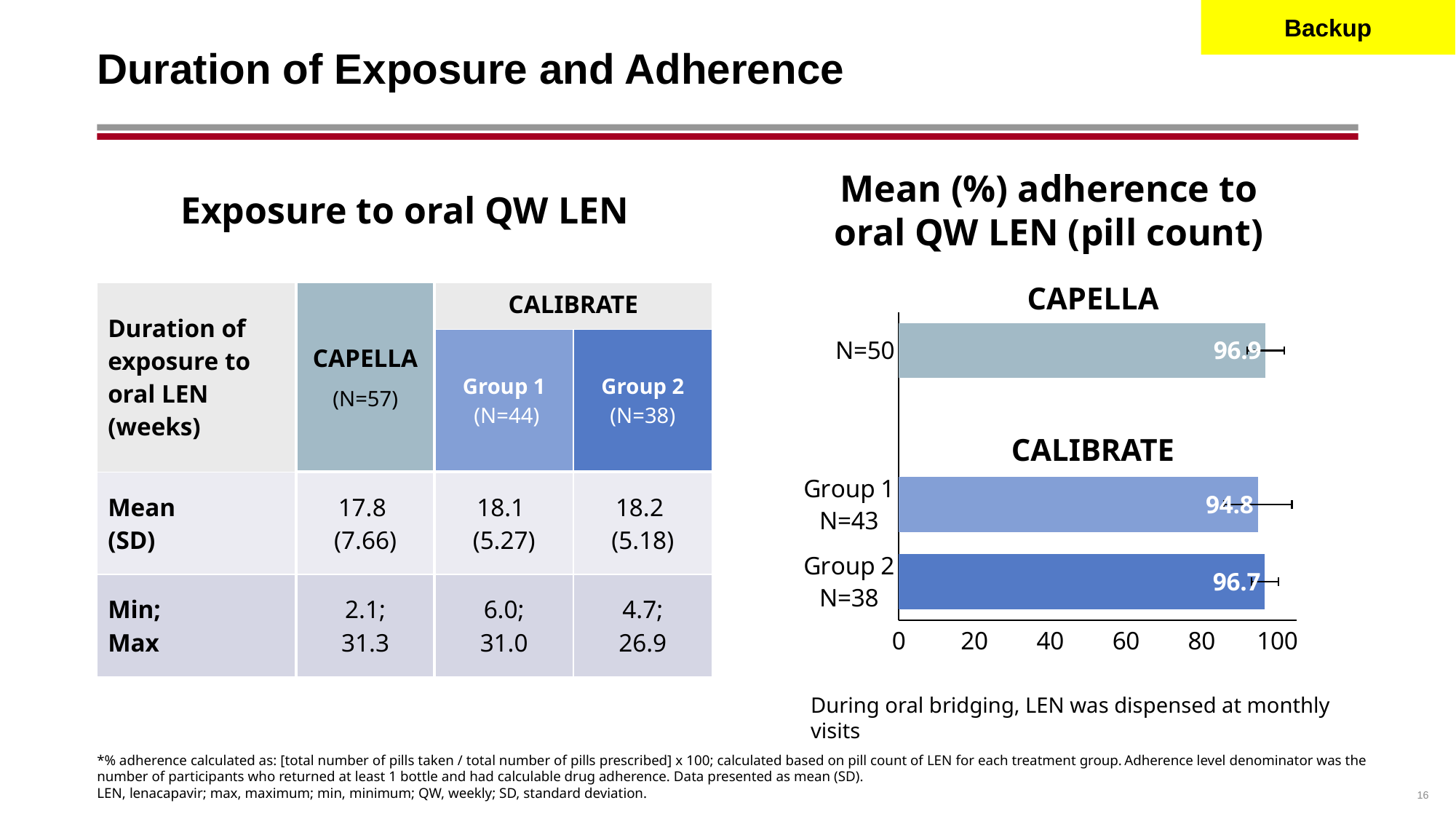
What is the mean (%) adherence for CALIBRATE Group 1 (N=43) in the bar chart? 94.8 What is the mean (%) adherence for CALIBRATE Group 2 (N=38) in the bar chart? 96.7 Which group has the lowest mean (%) adherence in the bar chart? CALIBRATE Group 1 Which group has the highest mean (%) adherence in the bar chart? CAPELLA What is the difference in mean (%) adherence between CAPELLA and CALIBRATE Group 1? 2.1 Which has the larger mean (%) adherence: CALIBRATE Group 1 or CALIBRATE Group 2? CALIBRATE Group 2 How many bars are shown in the adherence bar chart? 3 What is the difference in mean (%) adherence between CALIBRATE Group 2 and CALIBRATE Group 1? 1.9 What is the mean (%) adherence for CAPELLA (N=50) in the bar chart? 96.9 Is the mean (%) adherence for CALIBRATE Group 1 greater or less than 80? greater What type of chart is used to show mean (%) adherence to oral QW LEN? Bar chart What is the maximum value shown on the x axis of the adherence bar chart? 100